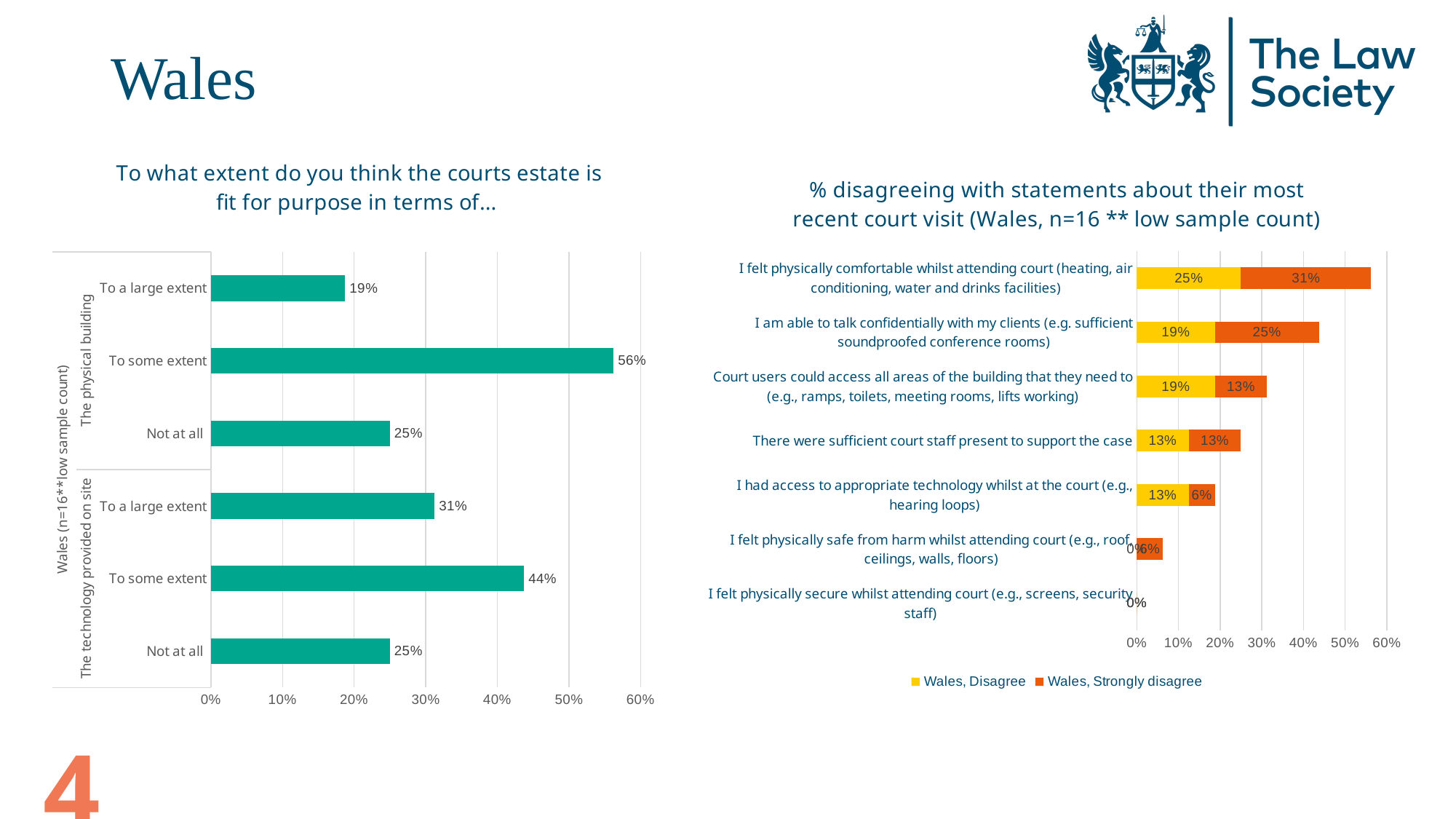
In the right chart, which colour represents 'Wales, Strongly disagree'? Orange In the left chart, what percentage said the technology provided on site is fit for purpose 'To a large extent'? 31% In the left chart, what is the difference between 'To some extent' for the physical building and 'To some extent' for the technology provided on site? 12% In the right chart, what percentage strongly disagreed with 'I felt physically comfortable whilst attending court'? 31% In the right chart, what is the total percentage disagreeing (Disagree plus Strongly disagree) with 'I am able to talk confidentially with my clients'? 44% In the right chart, which statement has the highest total percentage disagreeing? I felt physically comfortable whilst attending court (heating, air conditioning, water and drinks facilities) In the left chart, which is larger: 'To a large extent' for the physical building or 'To a large extent' for the technology provided on site? The technology provided on site In the right chart, how many series does the legend list? 2 In the left chart, which response has the highest value across both groups? To some extent (The physical building) In the left chart, what percentage said the physical building is fit for purpose 'To some extent'? 56% What type of chart is the left chart? Bar chart In the left chart, how many bars are plotted? 6